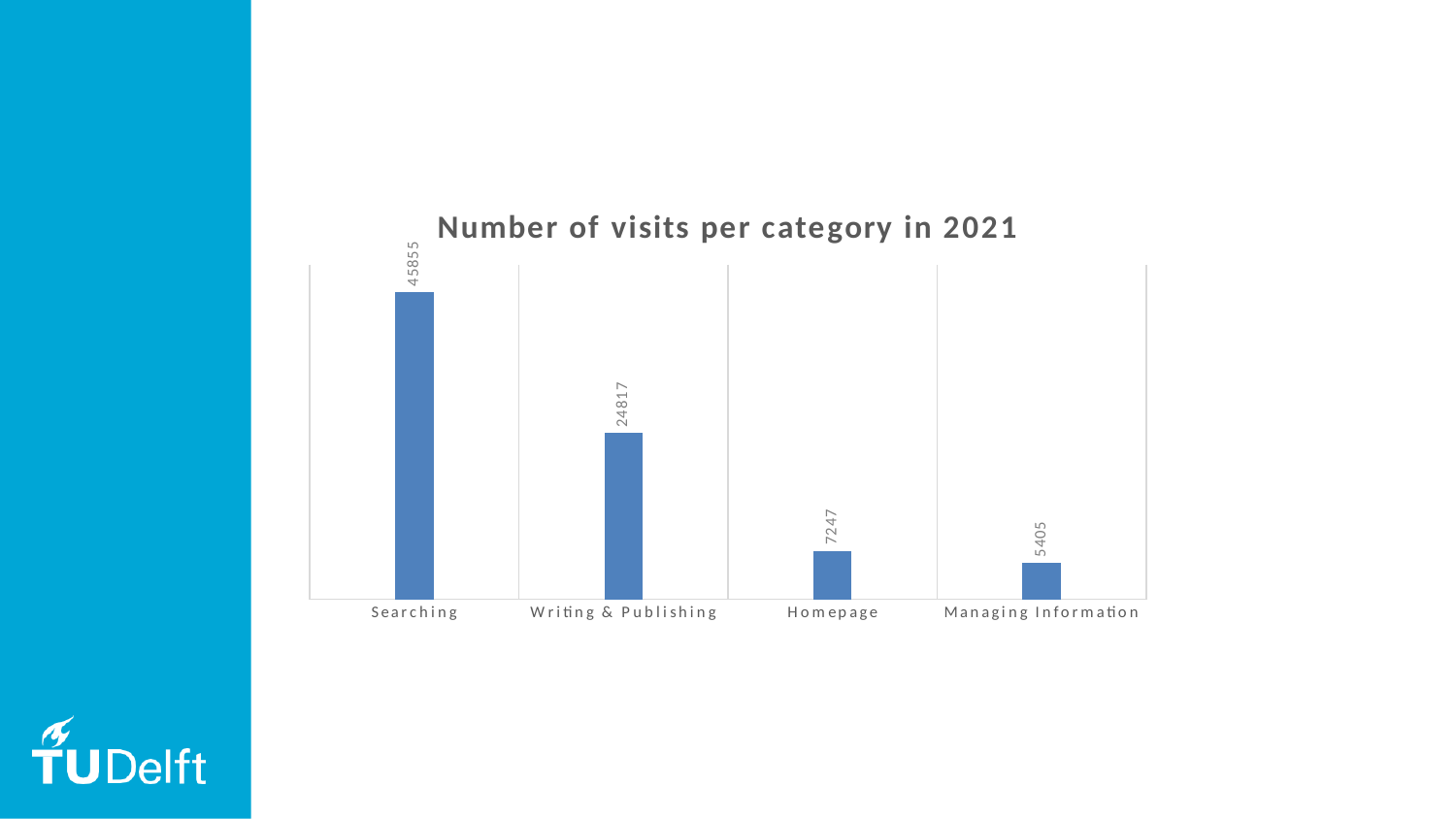
How many categories are shown in the chart? 4 What is the number of visits for Managing Information? 5405 What kind of chart is shown on the slide? Bar chart What is the number of visits for Searching? 45855 Which has more visits, Homepage or Managing Information? Homepage Which category has the highest number of visits? Searching What is the difference in visits between Searching and Writing & Publishing? 21038 Which category has the lowest number of visits? Managing Information What is the number of visits for Homepage? 7247 What is the difference in visits between Homepage and Managing Information? 1842 What is the number of visits for Writing & Publishing? 24817 What is the title of the chart? Number of visits per category in 2021